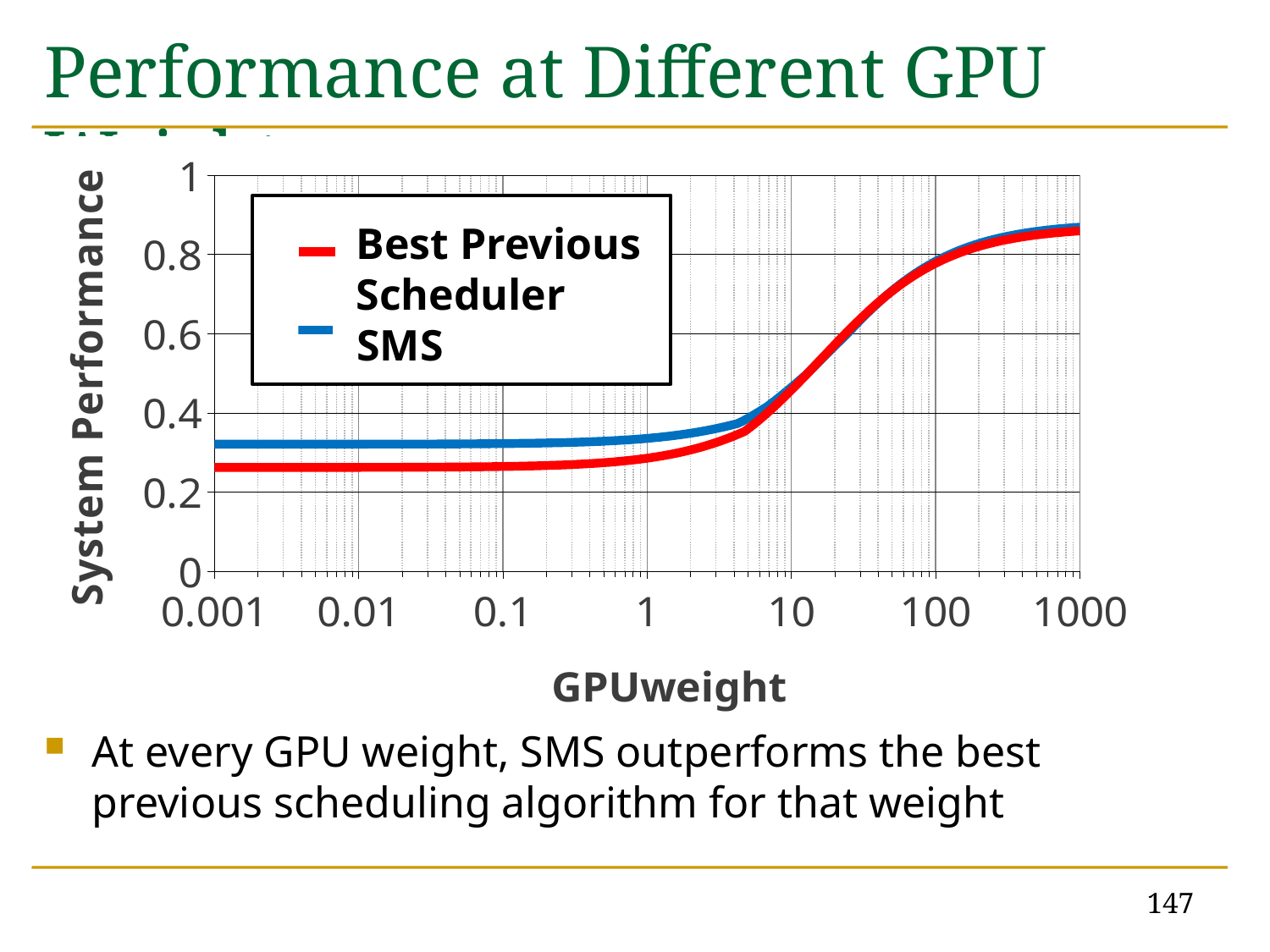
Is the System Performance of SMS at a GPUweight of 0.001 greater or less than 0.2? greater Is the System Performance of SMS at a GPUweight of 0.001 greater or less than 0.4? less Is the System Performance of SMS at a GPUweight of 1000 greater or less than 0.8? greater Which series is drawn in red? Best Previous Scheduler Do the System Performance values rise or fall as GPUweight increases? rise How many series does the legend list? 2 What kind of chart is shown on the slide? line chart What is the label of the x axis? GPUweight At a GPUweight of 0.001, which series has the higher System Performance, SMS or Best Previous Scheduler? SMS